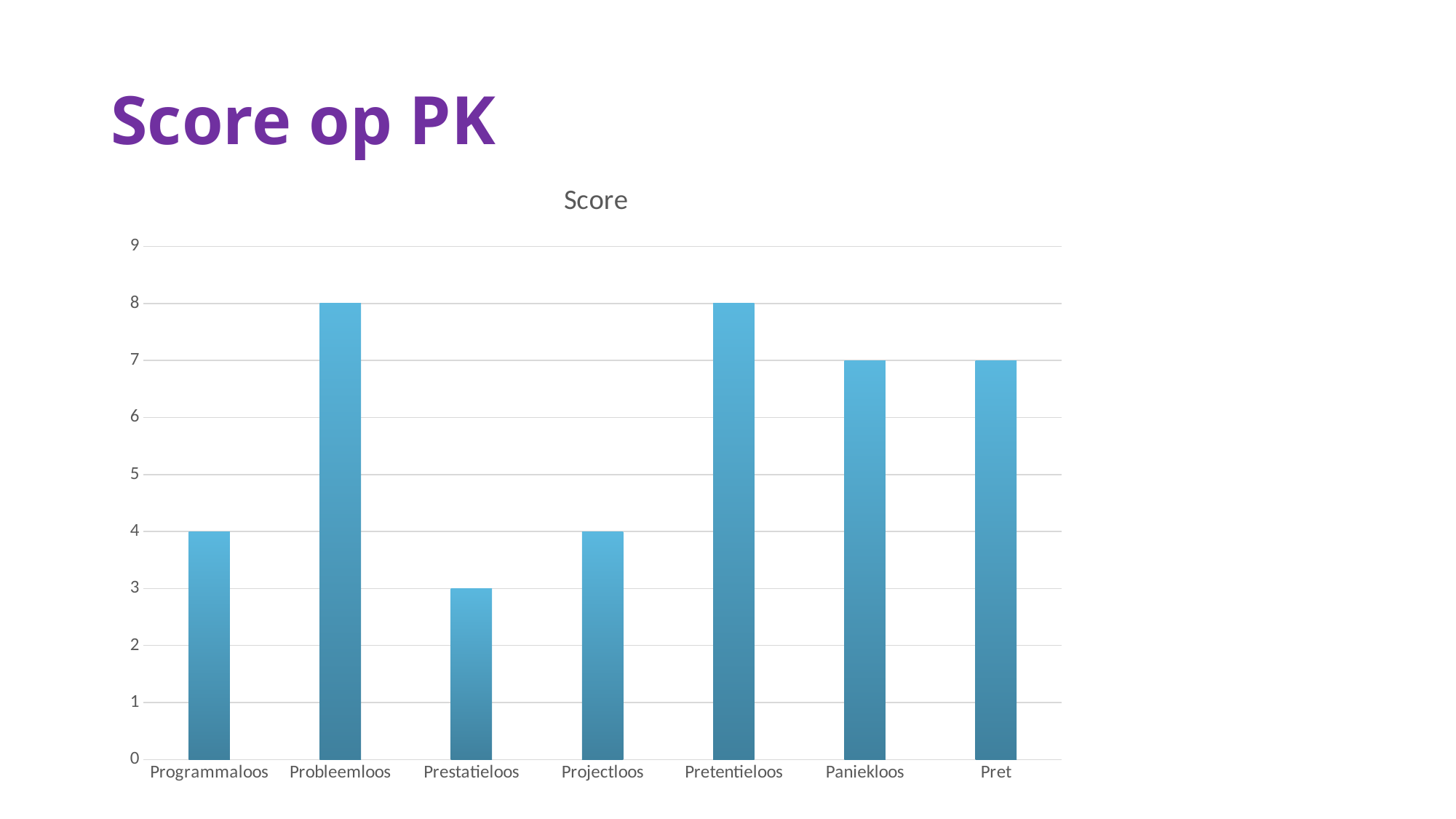
What is the score for Pretentieloos? 8 What is the title of the chart? Score What is the difference between the scores for Pret and Projectloos? 3 Is the score for Projectloos greater or less than 5? less What is the difference between the scores for Probleemloos and Prestatieloos? 5 Which has a higher score, Paniekloos or Programmaloos? Paniekloos Which category has the lowest score? Prestatieloos What is the score for Prestatieloos? 3 What is the score for Paniekloos? 7 What kind of chart is shown on the slide? bar chart What is the score for Programmaloos? 4 How many categories are shown on the x axis? 7